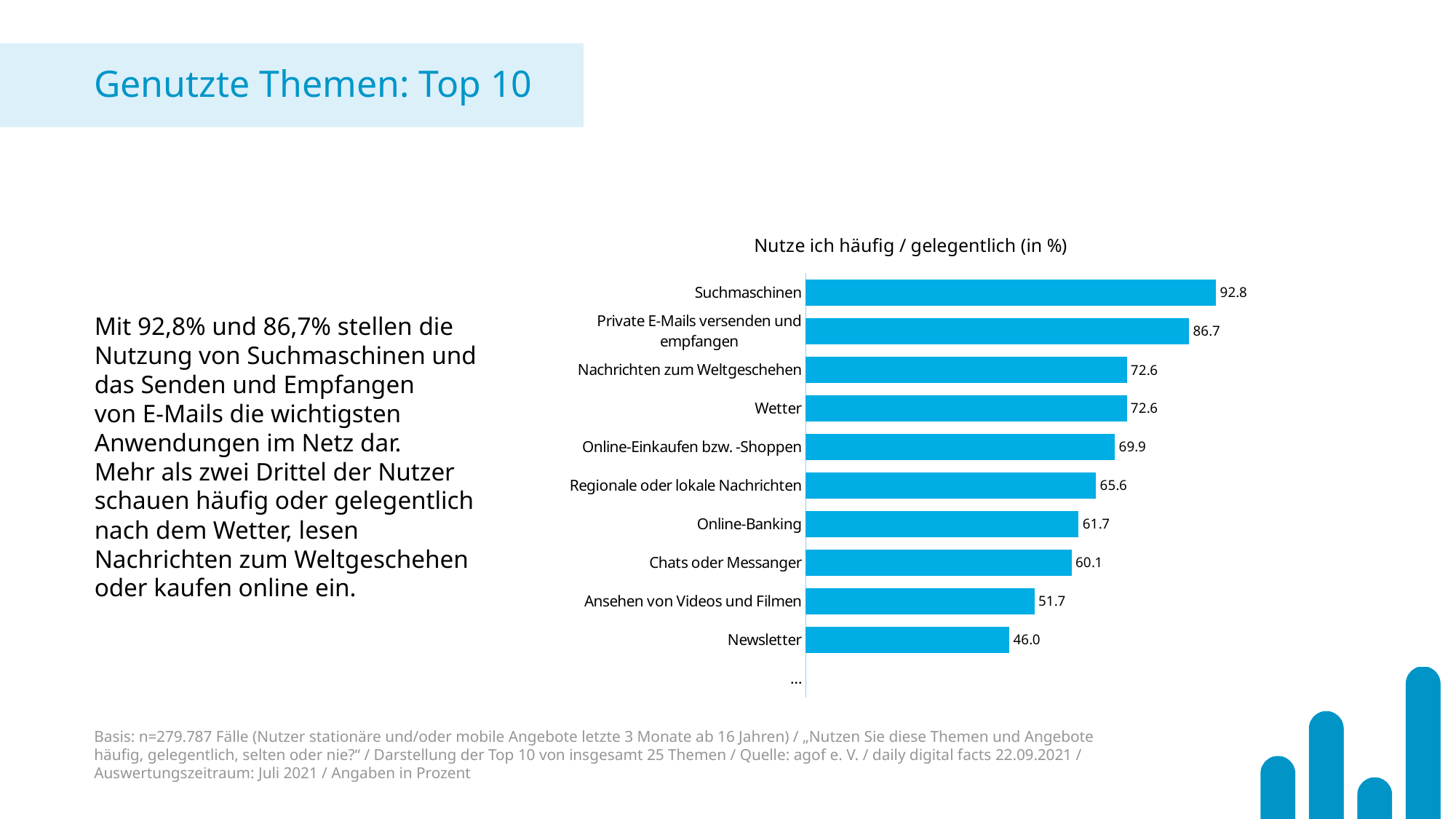
What is the difference between the values for Suchmaschinen and Private E-Mails versenden und empfangen? 6.1 What is the value for Ansehen von Videos und Filmen? 51.7 What kind of chart is shown on the slide? Bar chart Which category has the highest value? Suchmaschinen Which is larger, the value for Online-Einkaufen bzw. -Shoppen or the value for Regionale oder lokale Nachrichten? Online-Einkaufen bzw. -Shoppen What is the title of the chart? Nutze ich häufig / gelegentlich (in %) What is the value for Newsletter? 46.0 How many labelled categories with bars are shown in the chart? 10 What is the difference between the values for Chats oder Messanger and Newsletter? 14.1 What is the value for Online-Banking? 61.7 What is the value for Suchmaschinen? 92.8 Which labelled category has the lowest value? Newsletter